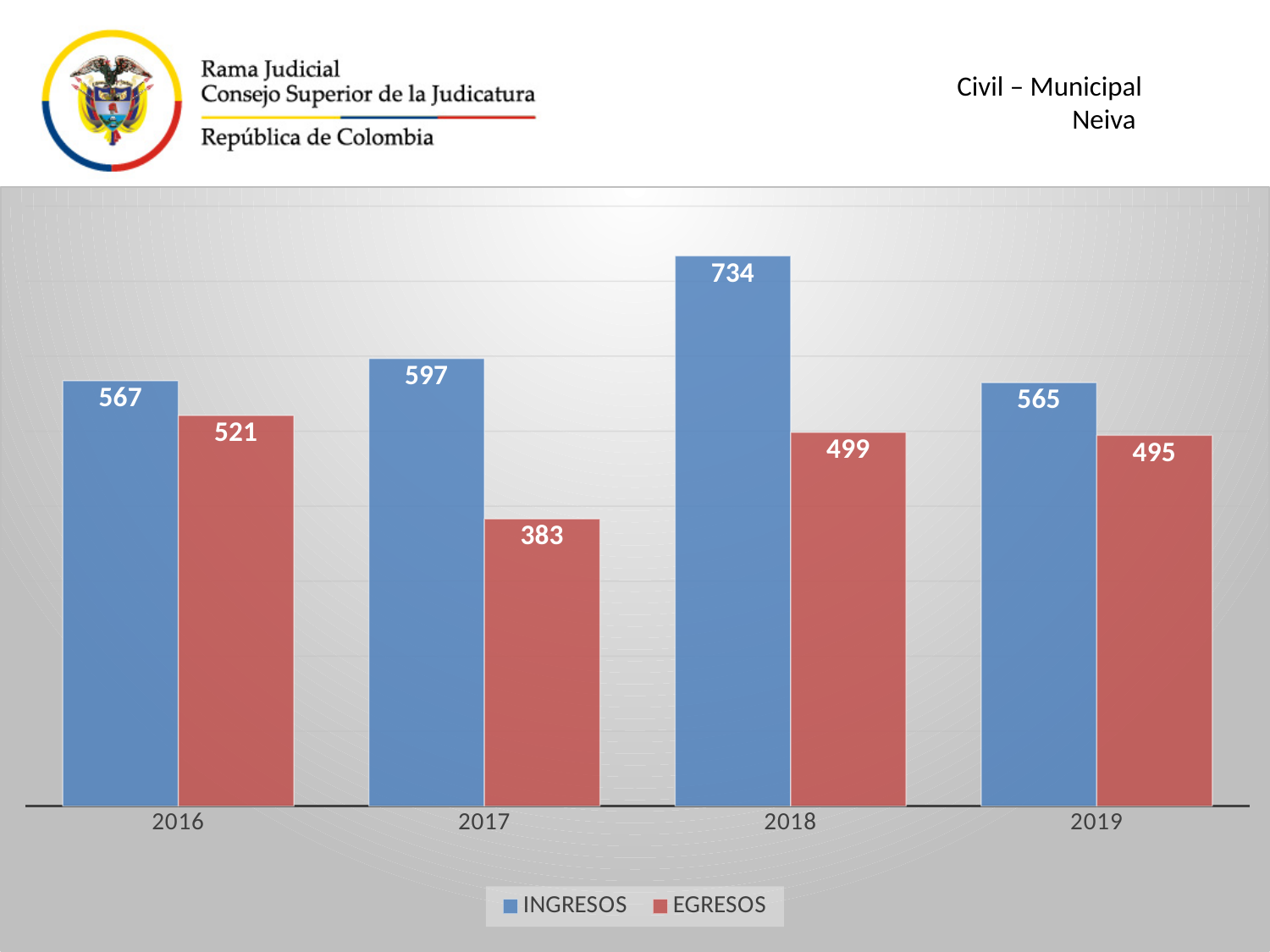
Which series is shown in red in the legend? EGRESOS What is the difference between INGRESOS and EGRESOS in 2018? 235 What kind of chart is shown on the slide? Bar chart What is the EGRESOS value for 2019? 495 Which is larger, EGRESOS in 2016 or EGRESOS in 2019? EGRESOS in 2016 How many series does the legend list? 2 How many years are shown on the x axis? 4 What is the EGRESOS value for 2017? 383 What is the INGRESOS value for 2018? 734 Which year has the lowest EGRESOS value? 2017 Which year has the highest INGRESOS value? 2018 What is the difference between the INGRESOS values for 2017 and 2016? 30